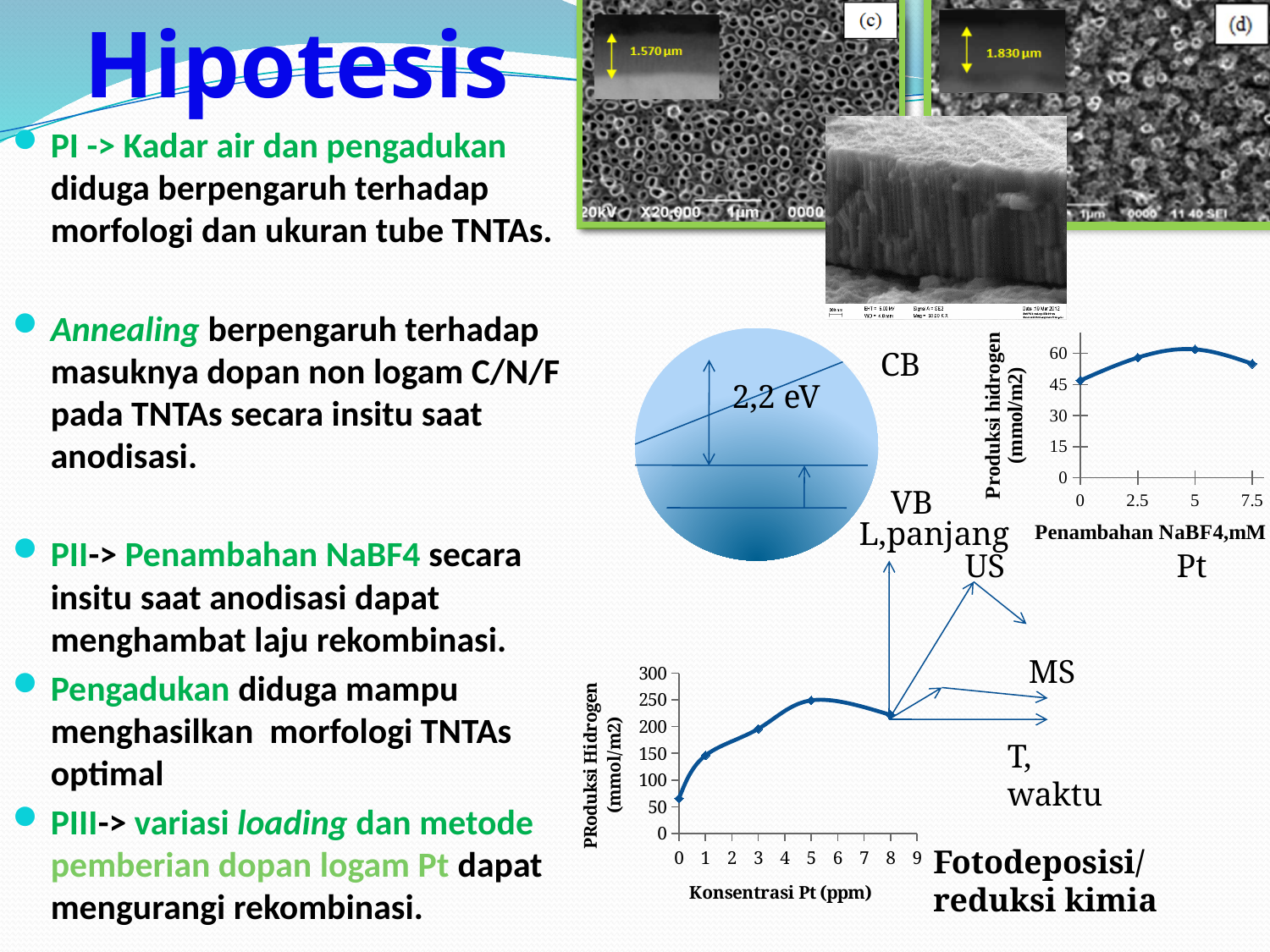
In the bottom chart (Konsentrasi Pt), is the hydrogen production at 5 ppm greater or less than 200? greater What kind of chart is the bottom chart with x axis 'Konsentrasi Pt (ppm)'? line chart What is the y-axis title of the bottom chart (Konsentrasi Pt)? PRoduksi Hidrogen (mmol/m2) What kind of chart is the top-right chart with x axis 'Penambahan NaBF4,mM'? line chart In the bottom chart (Konsentrasi Pt), do the values rise or fall from 0 ppm to 5 ppm? rise In the top-right chart (Penambahan NaBF4), at which NaBF4 addition is hydrogen production highest? 5 mM In the bottom chart (Konsentrasi Pt), how many data points are plotted? 5 In the top-right chart (Penambahan NaBF4), at which NaBF4 addition is hydrogen production lowest? 0 mM In the bottom chart (Konsentrasi Pt), at which Pt concentration is hydrogen production highest? 5 ppm In the bottom chart (Konsentrasi Pt), is the hydrogen production at 0 ppm greater or less than 100? less In the top-right chart (Penambahan NaBF4), is the hydrogen production at 0 mM greater or less than 60? less In the bottom chart (Konsentrasi Pt), at which Pt concentration is hydrogen production lowest? 0 ppm